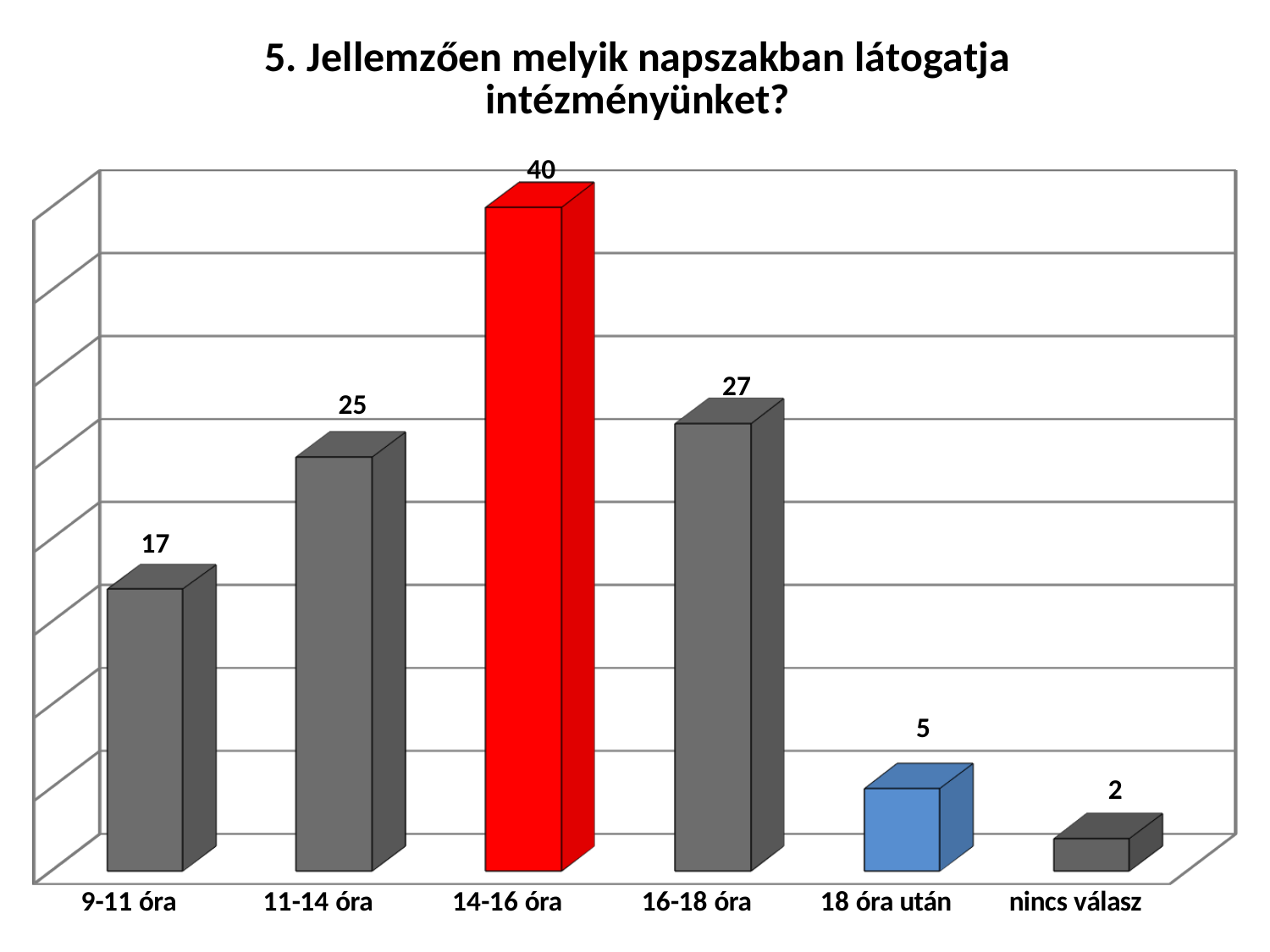
Which category has the lowest value? nincs válasz How many categories are shown on the x axis? 6 What colour is the bar for 14-16 óra? red What kind of chart is shown on the slide? bar chart Which category has the highest value? 14-16 óra What is the value for 18 óra után? 5 What is the value for 9-11 óra? 17 What is the value for 14-16 óra? 40 What is the difference between the values for 14-16 óra and 16-18 óra? 13 What is the difference between the values for 11-14 óra and 9-11 óra? 8 Which is larger, the value for 16-18 óra or the value for 11-14 óra? 16-18 óra What is the title of the chart? 5. Jellemzően melyik napszakban látogatja intézményünket?